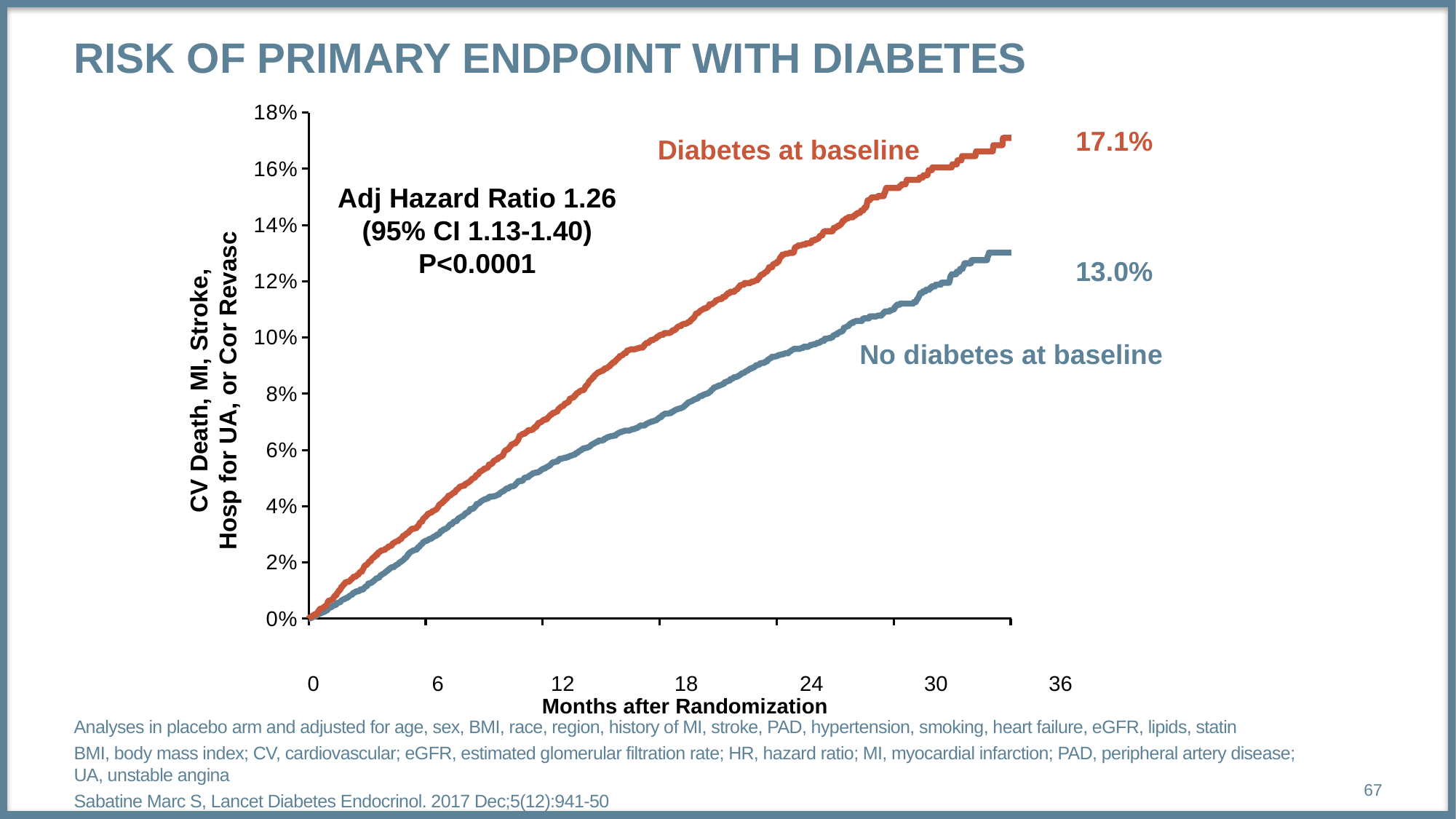
How many groups (curves) are plotted on the chart? 2 What is the difference between the final values of the Diabetes at baseline and No diabetes at baseline curves? 4.1% What adjusted hazard ratio is printed on the chart? 1.26 Do the curves rise or fall as months after randomization increase? Rise Is the value for the Diabetes at baseline curve at 12 months greater or less than 6%? greater Is the value for the Diabetes at baseline curve at 30 months greater or less than 14%? greater What kind of chart is shown on the slide? Line chart Which curve ends at the lowest value? No diabetes at baseline Which group has the higher final event rate, Diabetes at baseline or No diabetes at baseline? Diabetes at baseline What is the final value shown for the No diabetes at baseline curve? 13.0% Is the value for the No diabetes at baseline curve at 24 months greater or less than 10%? less What is the final value shown for the Diabetes at baseline curve? 17.1%